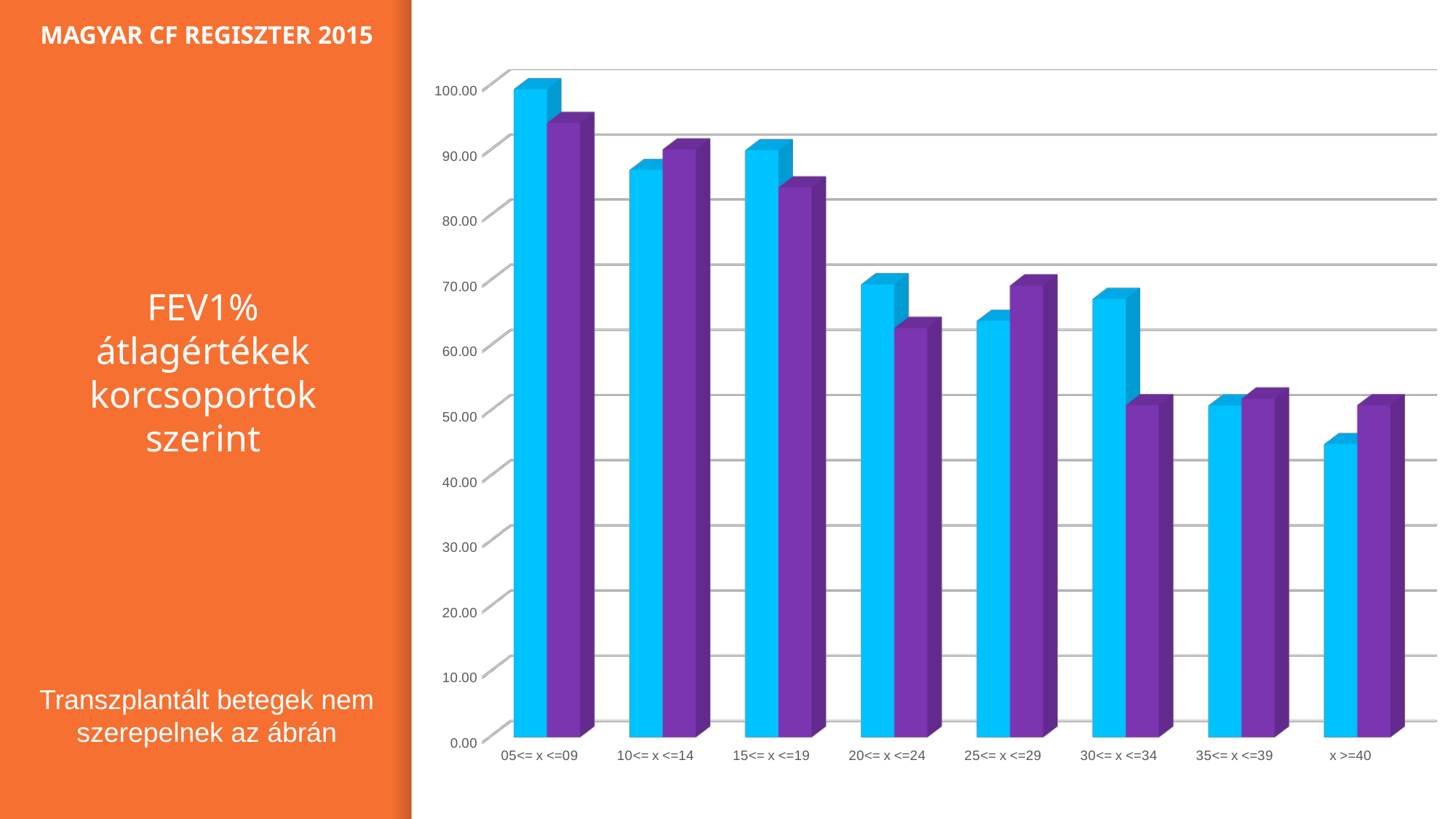
Is the value of the blue bar for 10<= x <=14 greater or less than 90? less Which age group has the tallest purple bar? 05<= x <=09 According to the slide text, what does the chart show? FEV1% átlagértékek korcsoportok szerint Which age group has the tallest blue bar? 05<= x <=09 Is the value of the purple bar for 15<= x <=19 greater or less than 80? greater Is the value of the purple bar for 05<= x <=09 greater or less than 90? greater Do the blue bars generally rise or fall from the youngest age group to the oldest? fall What kind of chart is shown on the slide? bar chart Which age group has the shortest blue bar? x >=40 For the 30<= x <=34 age group, which bar is taller, the blue one or the purple one? the blue one How many age-group categories are shown on the x axis? 8